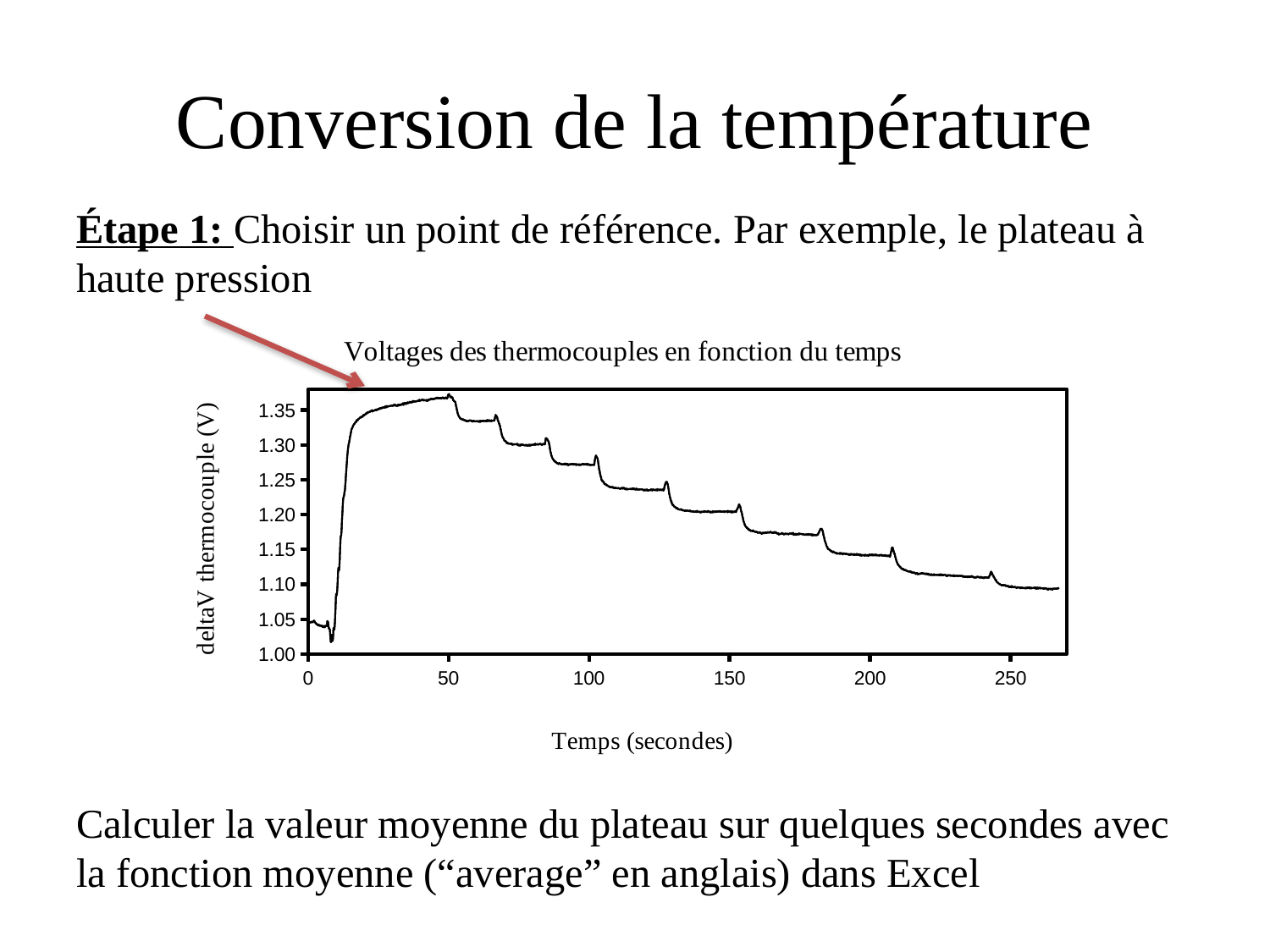
Which is larger, the thermocouple voltage at 100 seconds or at 200 seconds? 100 seconds Is the value of the thermocouple voltage at 150 seconds greater or less than 1.15? greater What is the title of the chart? Voltages des thermocouples en fonction du temps Is the value of the thermocouple voltage at 250 seconds greater or less than 1.15? less Is the value of the thermocouple voltage at 0 seconds greater or less than 1.10? less What is the highest tick value shown on the x axis? 250 What is the label of the x axis of the chart? Temps (secondes) What kind of chart is shown on the slide? line chart Between 0 and 50 seconds, does the thermocouple voltage rise or fall overall? rise After about 50 seconds, does the thermocouple voltage rise or fall as time increases? fall